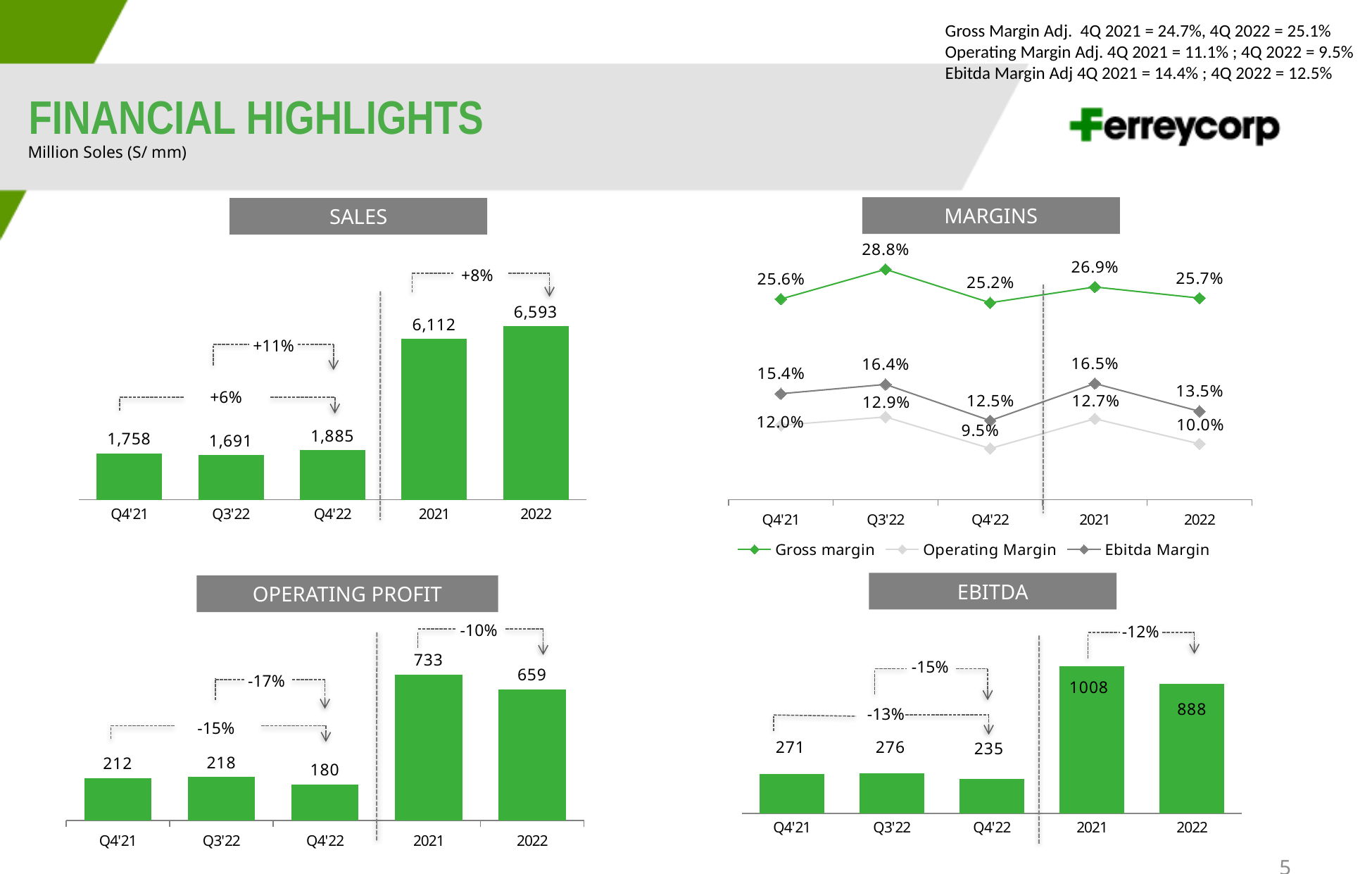
In the EBITDA chart, which is larger, the value for Q4'21 or Q3'22? Q3'22 What kind of chart is the MARGINS chart? line chart In the MARGINS chart, which period has the lowest Operating Margin? Q4'22 How many categories are shown on the x axis of the OPERATING PROFIT chart? 5 In the OPERATING PROFIT chart, which period has the highest value? 2021 What kind of chart is the SALES chart? bar chart In the SALES chart, what is the value for Q4'22? 1,885 In the EBITDA chart, what is the value for 2022? 888 In the MARGINS chart, what is the Gross margin for Q3'22? 28.8% How many series does the legend of the MARGINS chart list? 3 In the EBITDA chart, what is the difference between the 2021 and 2022 values? 120 In the SALES chart, what is the difference between the 2022 and 2021 values? 481